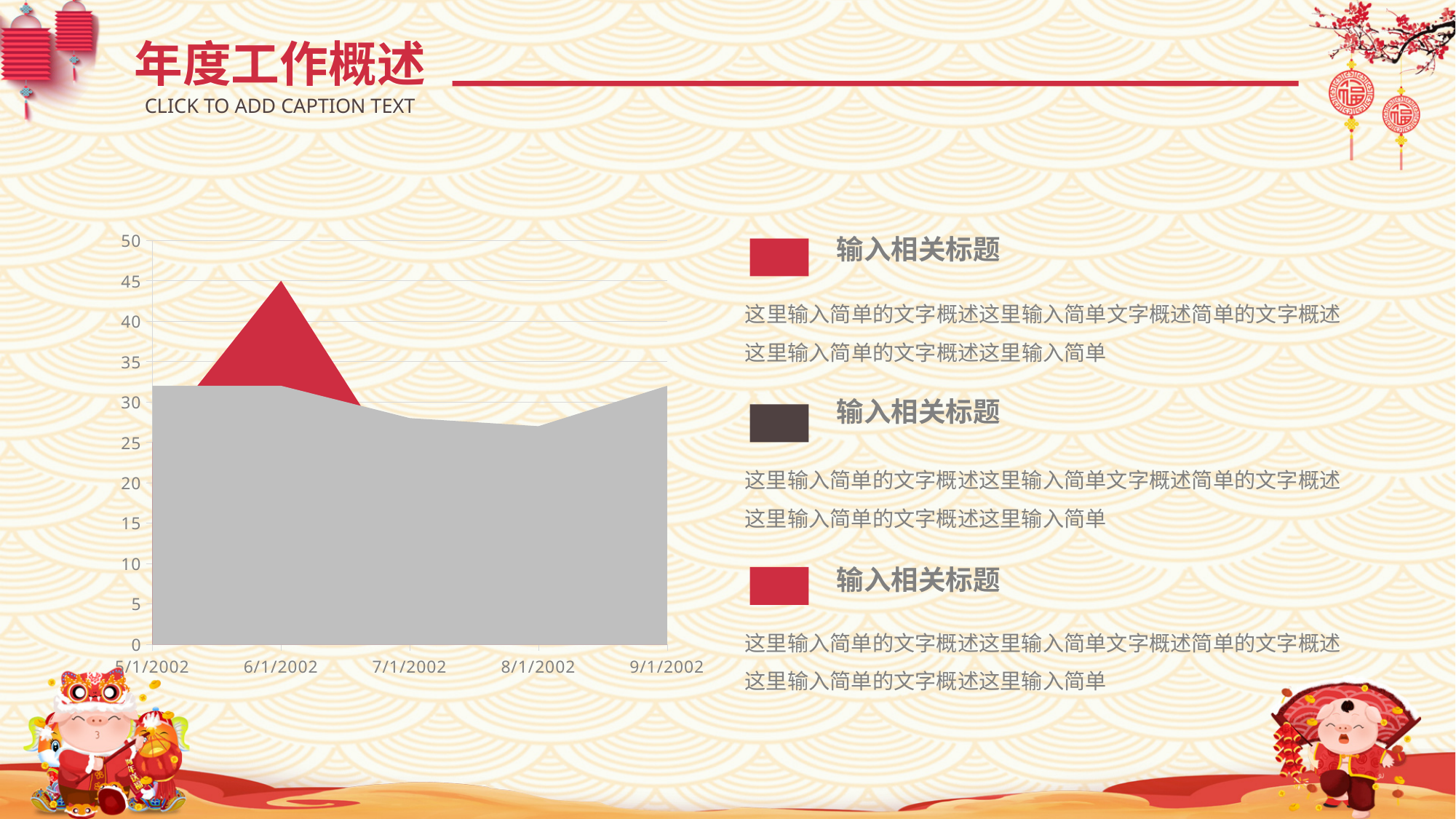
For the gray series, which is larger: the value at 6/1/2002 or the value at 8/1/2002? 6/1/2002 Is the value of the red series at 6/1/2002 greater or less than 40? greater At 6/1/2002, which series has the larger value, the red one or the gray one? the red one At which date does the red series reach its highest value? 6/1/2002 What is the highest value shown on the chart's y axis? 50 Is the value of the gray series at 5/1/2002 greater or less than 25? greater Is the value of the gray series at 9/1/2002 greater or less than 30? greater Does the gray series rise or fall from 6/1/2002 to 8/1/2002? fall What kind of chart is shown on the slide? area chart How many dates are labelled along the x axis of the chart? 5 Does the gray series rise or fall from 8/1/2002 to 9/1/2002? rise